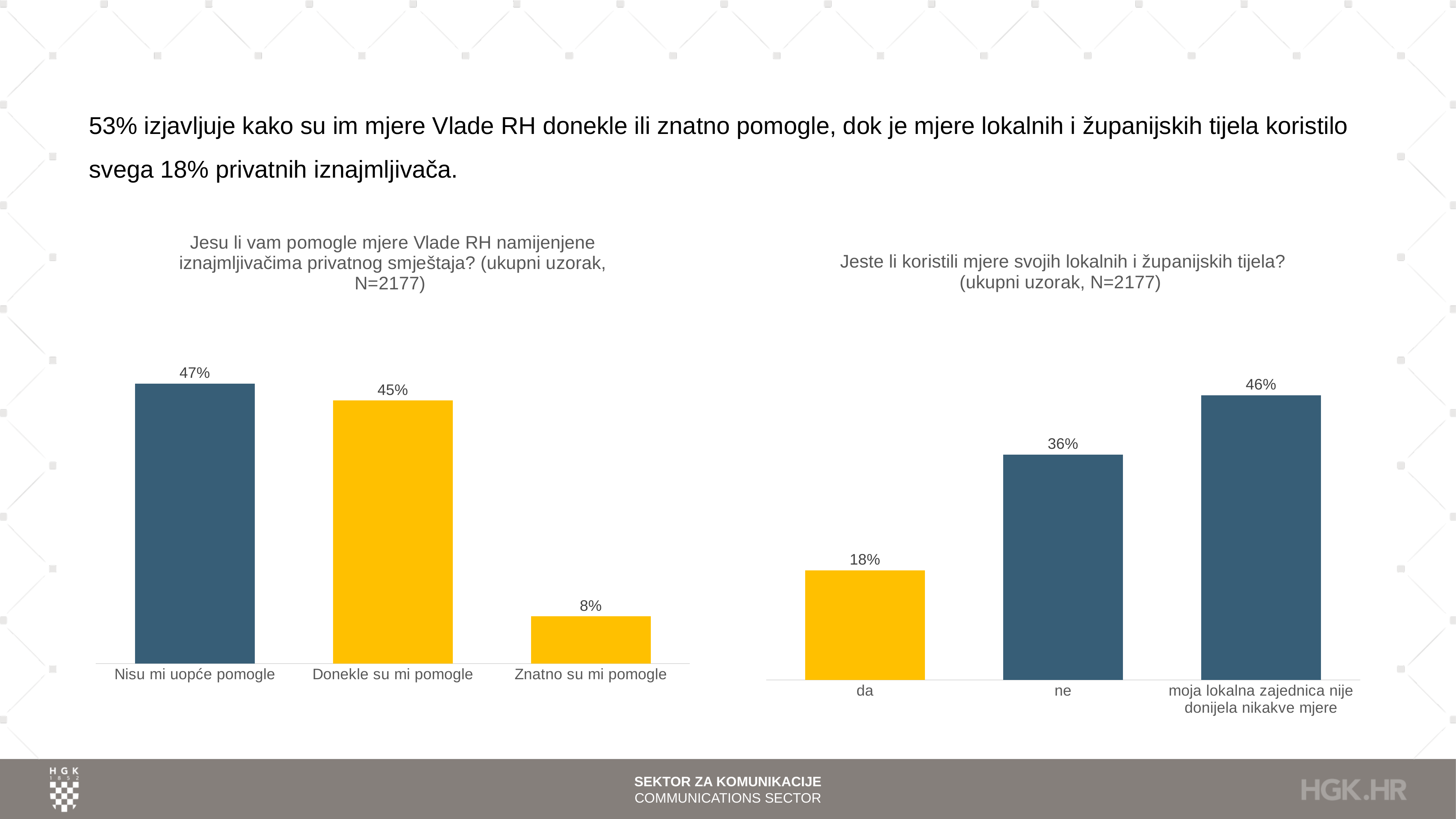
In the right chart (Jeste li koristili mjere svojih lokalnih i županijskih tijela?), what is the value for 'ne'? 36% In the left chart (Jesu li vam pomogle mjere Vlade RH...), what is the value for 'Znatno su mi pomogle'? 8% In the right chart (Jeste li koristili mjere svojih lokalnih i županijskih tijela?), what is the value for 'da'? 18% In the right chart (Jeste li koristili mjere svojih lokalnih i županijskih tijela?), what is the difference between 'moja lokalna zajednica nije donijela nikakve mjere' and 'da'? 28% In the left chart (Jesu li vam pomogle mjere Vlade RH...), what is the value for 'Nisu mi uopće pomogle'? 47% In the right chart (Jeste li koristili mjere svojih lokalnih i županijskih tijela?), which is larger: 'ne' or 'da'? ne What kind of chart is the right chart (Jeste li koristili mjere svojih lokalnih i županijskih tijela?)? bar chart In the right chart (Jeste li koristili mjere svojih lokalnih i županijskih tijela?), what colour is the bar for 'da'? yellow In the left chart (Jesu li vam pomogle mjere Vlade RH...), what is the difference between 'Donekle su mi pomogle' and 'Znatno su mi pomogle'? 37% In the left chart (Jesu li vam pomogle mjere Vlade RH...), which category has the lowest value? Znatno su mi pomogle In the right chart (Jeste li koristili mjere svojih lokalnih i županijskih tijela?), which category has the highest value? moja lokalna zajednica nije donijela nikakve mjere How many categories does the left chart (Jesu li vam pomogle mjere Vlade RH...) show? 3